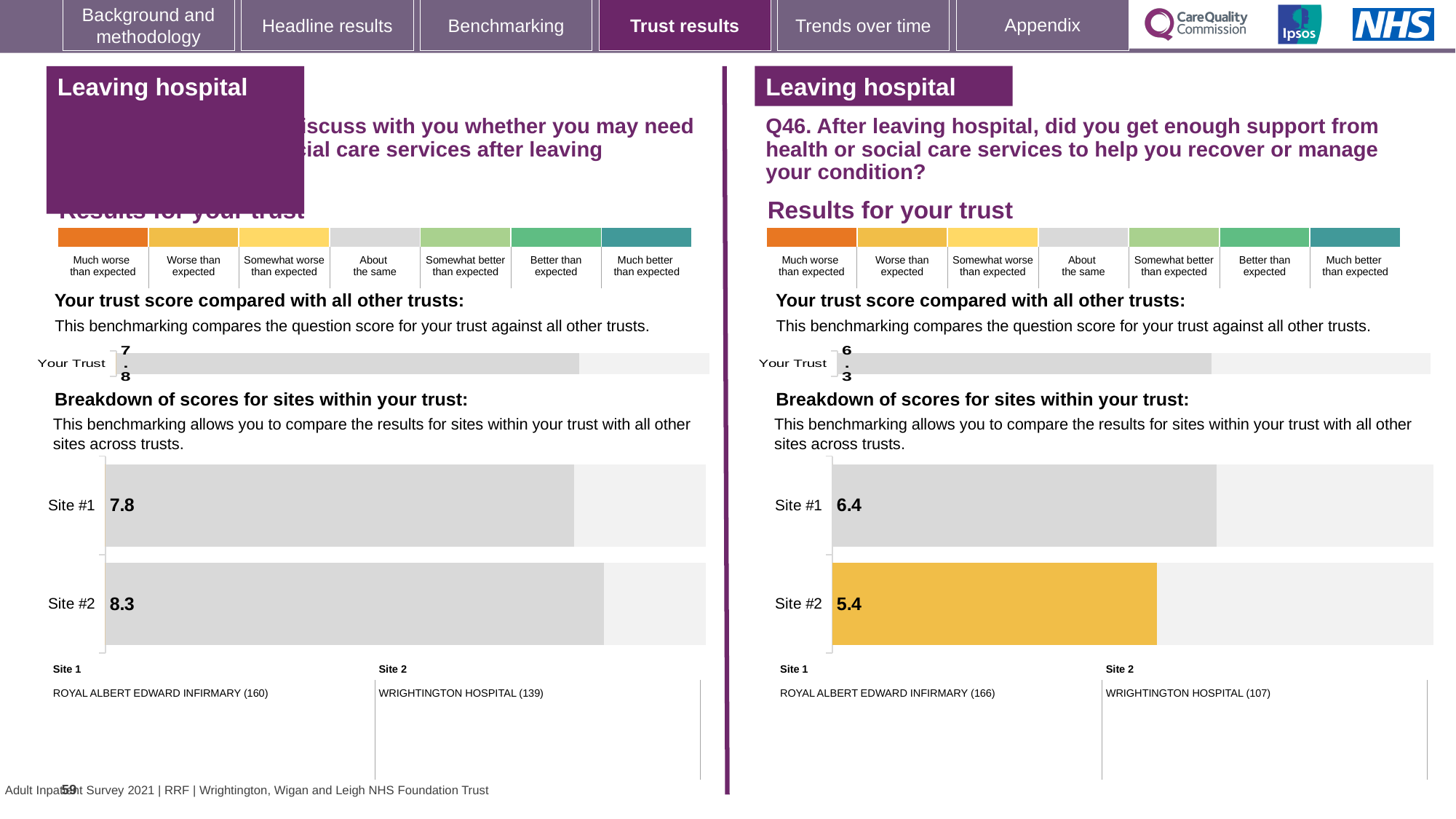
In the right-hand (Q46) 'Your trust score compared with all other trusts' chart, what is the score shown for Your Trust? 6.3 In the left-hand 'Your trust score compared with all other trusts' chart, what is the score shown for Your Trust? 7.8 How many sites are shown in the right-hand (Q46) site breakdown chart? 2 In the right-hand (Q46) site breakdown chart, what is the score for Site #2? 5.4 In the left-hand site breakdown chart, what is the score for Site #2? 8.3 In the left-hand site breakdown chart, what is the score for Site #1? 7.8 What type of chart is used for the site breakdown of scores on the slide? Bar chart In the right-hand (Q46) site breakdown chart, which site has the higher score? Site #1 In the left-hand site breakdown chart, what is the difference between the Site #2 and Site #1 scores? 0.5 In the right-hand (Q46) site breakdown chart, what is the score for Site #1? 6.4 In the left-hand site breakdown chart, which site has the lower score? Site #1 In the right-hand (Q46) site breakdown chart, what is the difference between the Site #1 and Site #2 scores? 1.0